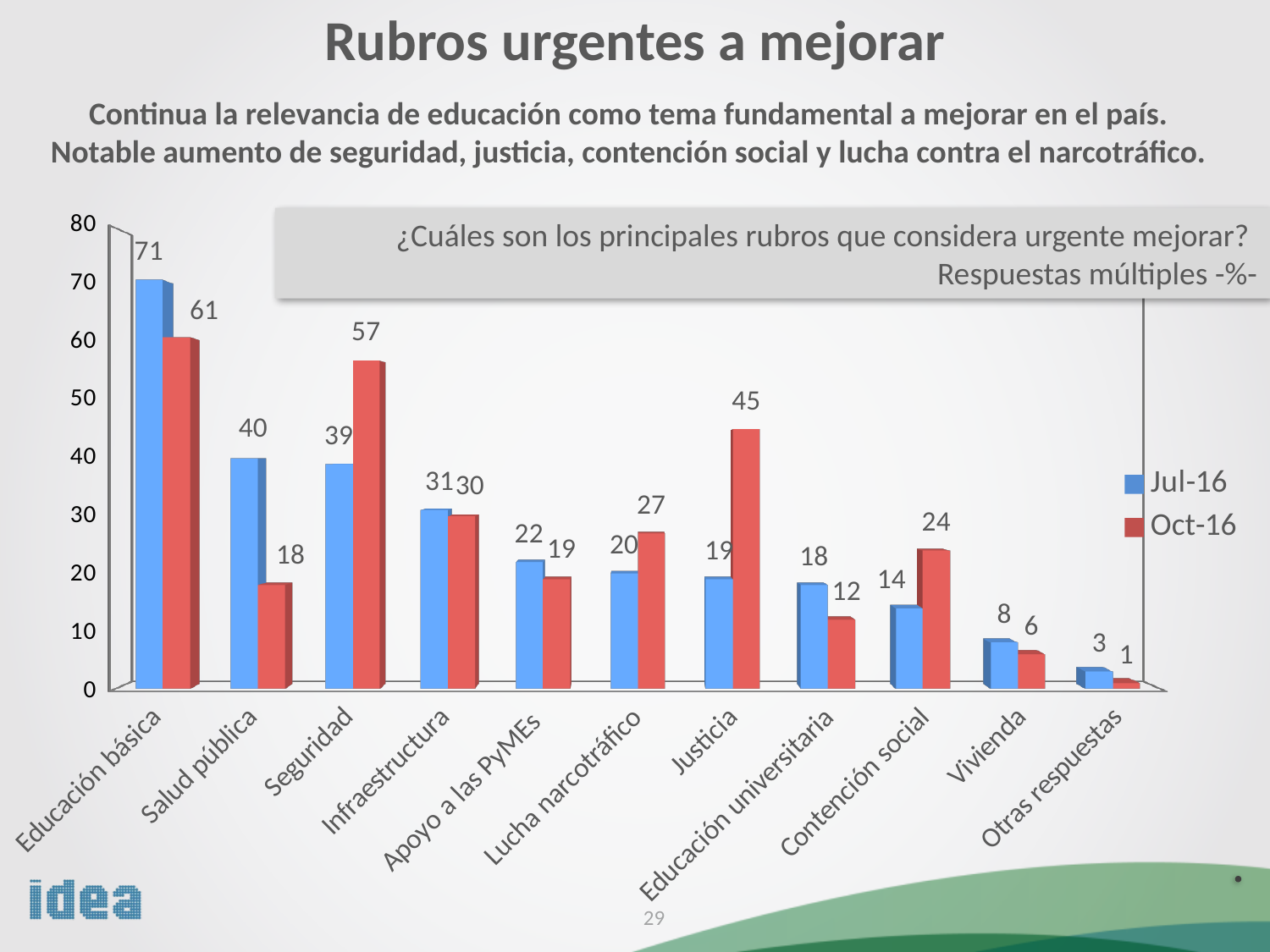
How many series does the legend list? 2 What is the Jul-16 value for Salud pública? 40 Which category has the lowest Oct-16 value? Otras respuestas Which series is shown in red in the legend? Oct-16 What kind of chart is shown on the slide? Bar chart Which category has the highest Jul-16 value? Educación básica What is the Oct-16 value for Contención social? 24 What is the difference between the Oct-16 and Jul-16 values for Justicia? 26 Which is larger for Lucha narcotráfico, the Jul-16 value or the Oct-16 value? Oct-16 How many categories are shown on the x axis? 11 Is the Oct-16 value for Educación básica greater or less than 50? greater What is the Oct-16 value for Seguridad? 57